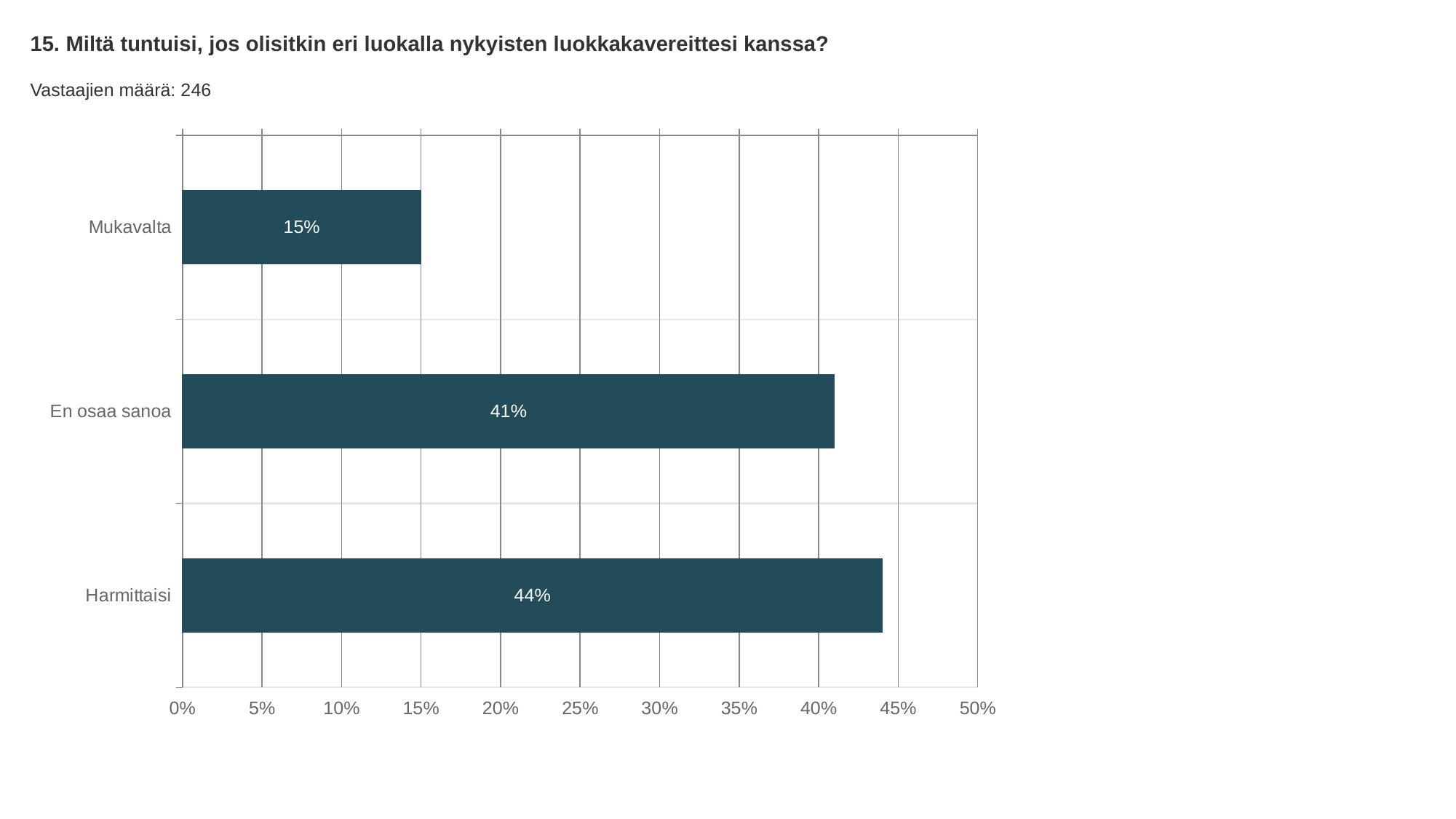
Which is larger, the value for En osaa sanoa or the value for Mukavalta? En osaa sanoa What is the value for En osaa sanoa? 41% What is the value for Mukavalta? 15% Which category has the highest value? Harmittaisi What is the difference between the values for Harmittaisi and Mukavalta? 29% How many categories are shown in the chart? 3 Is the value for En osaa sanoa greater or less than 30%? greater What kind of chart is shown on the slide? bar chart How many respondents (Vastaajien määrä) are reported on the slide? 246 What is the difference between the values for Harmittaisi and En osaa sanoa? 3% What is the value for Harmittaisi? 44% Which category has the lowest value? Mukavalta